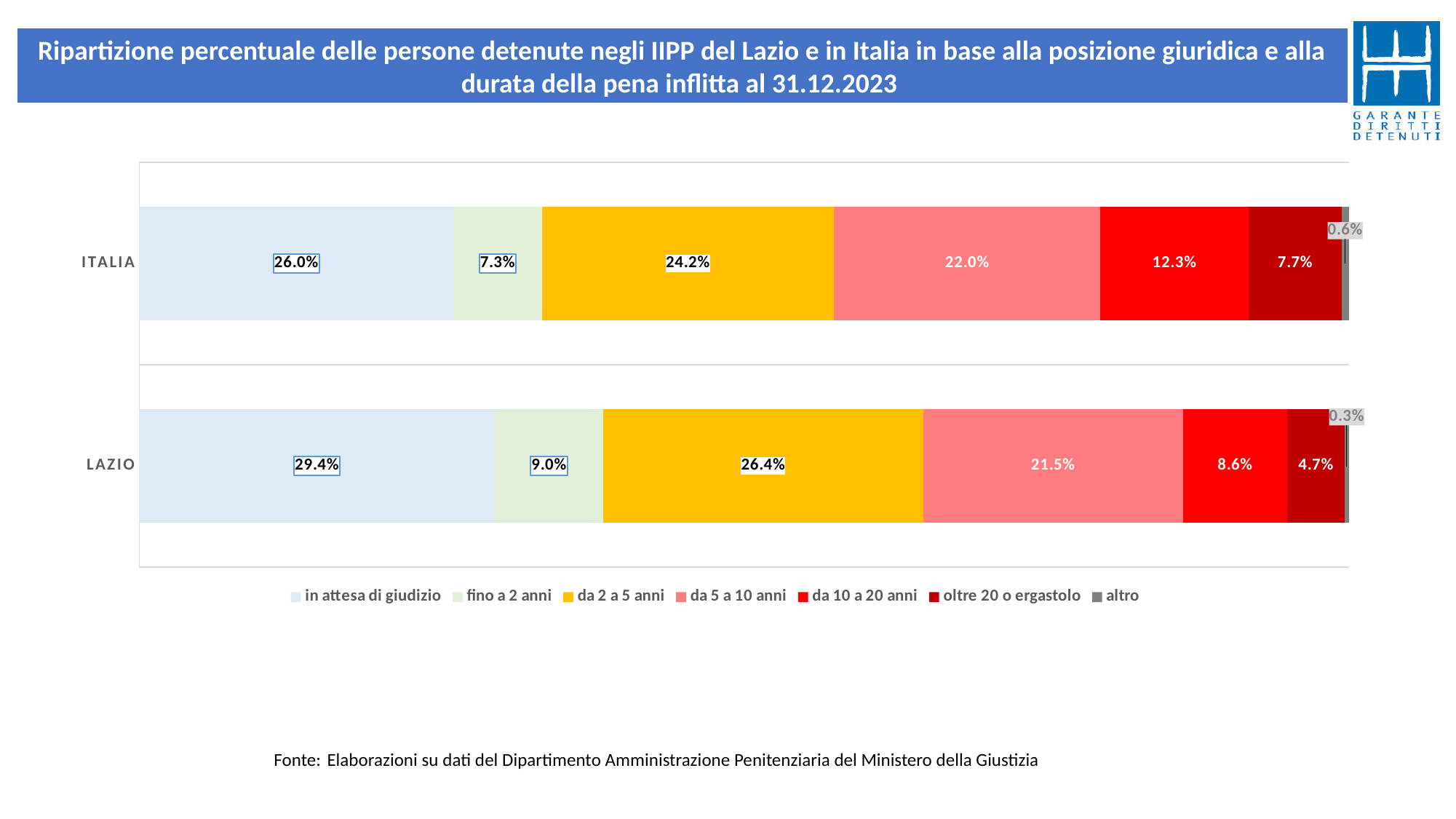
How many categories (bars) are shown on the chart? 2 What is the value for 'altro' for ITALIA? 0.6% Which series has the lowest value in the ITALIA bar? altro What kind of chart is shown on the slide? Stacked bar chart What is the value for 'oltre 20 o ergastolo' for LAZIO? 4.7% Which series has the highest value in the LAZIO bar? in attesa di giudizio What is the difference between the 'in attesa di giudizio' values for LAZIO and ITALIA? 3.4 percentage points How many series does the legend list? 7 What is the value for 'da 2 a 5 anni' for LAZIO? 26.4% What is the value for 'in attesa di giudizio' for ITALIA? 26.0% Which is larger, the 'da 10 a 20 anni' value for ITALIA or for LAZIO? ITALIA What is the difference between the 'oltre 20 o ergastolo' values for ITALIA and LAZIO? 3.0 percentage points